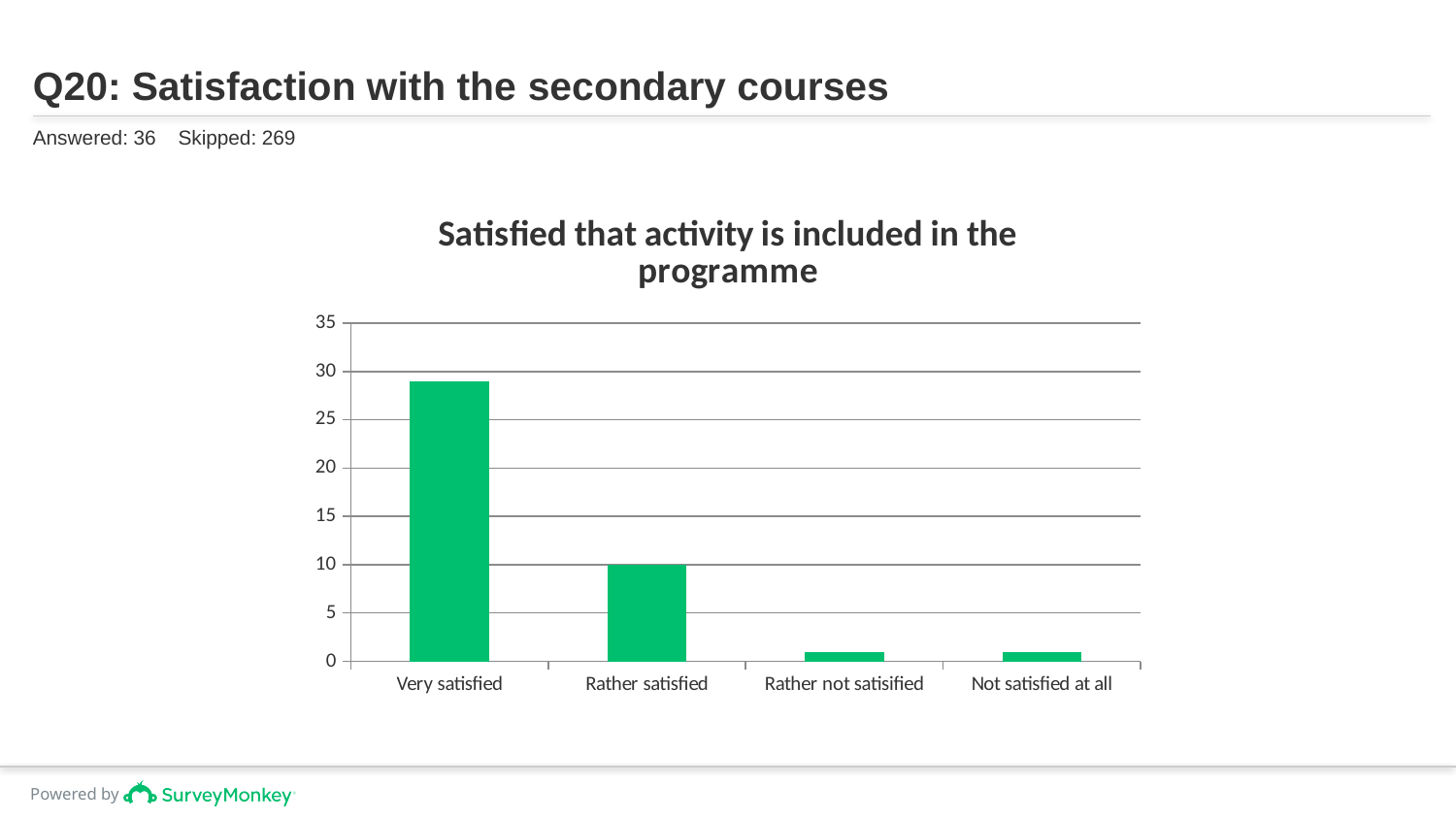
Is the value for Very satisfied greater or less than 30? less Do the values generally rise or fall moving from left to right along the x axis? fall Which category has the highest value in the chart? Very satisfied What is the value for Rather satisfied? 10 What is the title of the chart? Satisfied that activity is included in the programme Is the value for Very satisfied greater or less than 25? greater What colour are the bars in the chart? green What kind of chart is shown on the slide? bar chart Is the value for Rather not satisified greater or less than 5? less Which is larger, the value for Very satisfied or the value for Rather satisfied? Very satisfied How many categories are shown on the x axis of the chart? 4